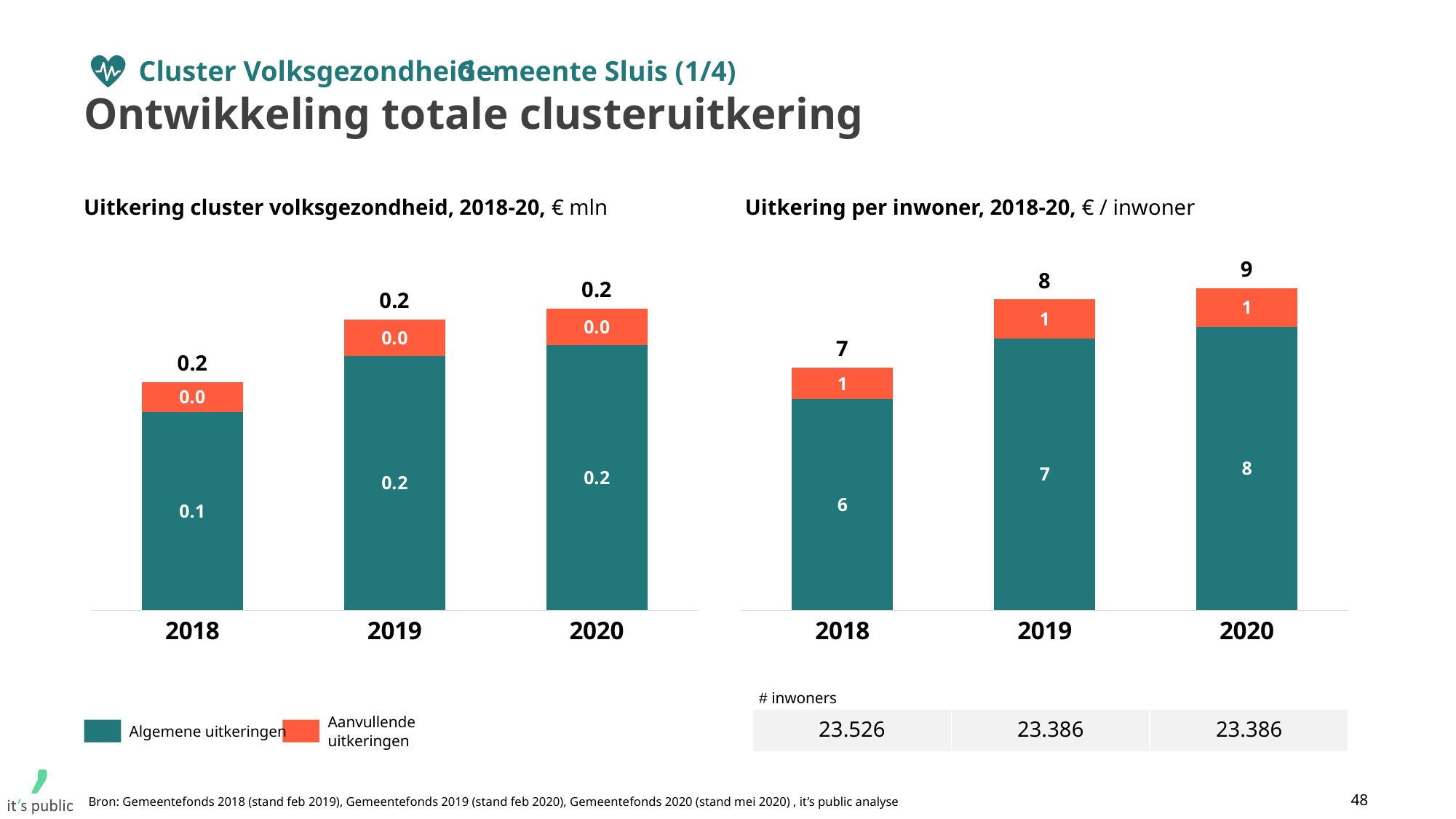
In the chart 'Uitkering per inwoner, 2018-20', what is the difference between the total for 2020 and the total for 2018? 2 In the chart 'Uitkering cluster volksgezondheid, 2018-20', what is the value of Algemene uitkeringen for 2018? 0.1 How many series does the legend list for the charts on this slide? 2 In the chart 'Uitkering cluster volksgezondheid, 2018-20', what is the total shown above the bar for 2019? 0.2 In the chart 'Uitkering per inwoner, 2018-20', which year has the lowest total? 2018 In the chart 'Uitkering per inwoner, 2018-20', what is the total shown above the bar for 2020? 9 What kind of chart is 'Uitkering per inwoner, 2018-20'? Stacked bar chart In the chart 'Uitkering per inwoner, 2018-20', what is the value of Aanvullende uitkeringen for 2019? 1 In the chart 'Uitkering per inwoner, 2018-20', do the totals rise or fall from 2018 to 2020? rise In the chart 'Uitkering per inwoner, 2018-20', which year has the highest total? 2020 In the chart 'Uitkering per inwoner, 2018-20', what is the value of Algemene uitkeringen for 2018? 6 How many years are shown on the x axis of the chart 'Uitkering cluster volksgezondheid, 2018-20'? 3